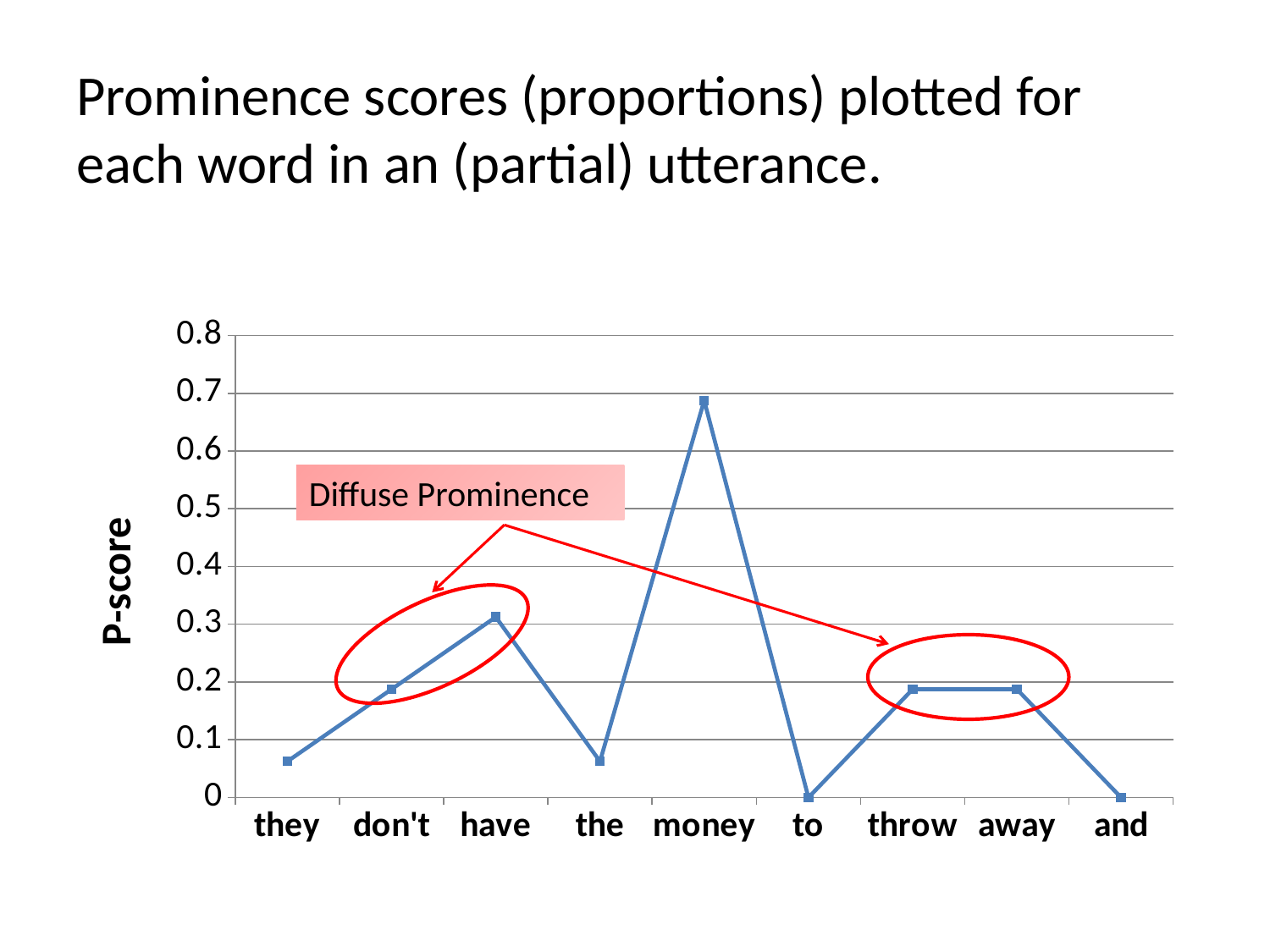
What is the label on the vertical axis? P-score How many words are plotted along the x axis? 9 Do the P-scores rise or fall from "the" to "money"? rise What kind of chart is shown on the slide? line chart Is the P-score for "money" greater or less than 0.6? greater Is the P-score for "have" greater or less than 0.4? less What is the P-score for "and"? 0 Is the P-score for "they" greater or less than 0.1? less What text appears in the annotation box pointing to the circled regions? Diffuse Prominence Which word has the highest P-score? money Which has a higher P-score, "have" or "don't"? have What is the P-score for "to"? 0